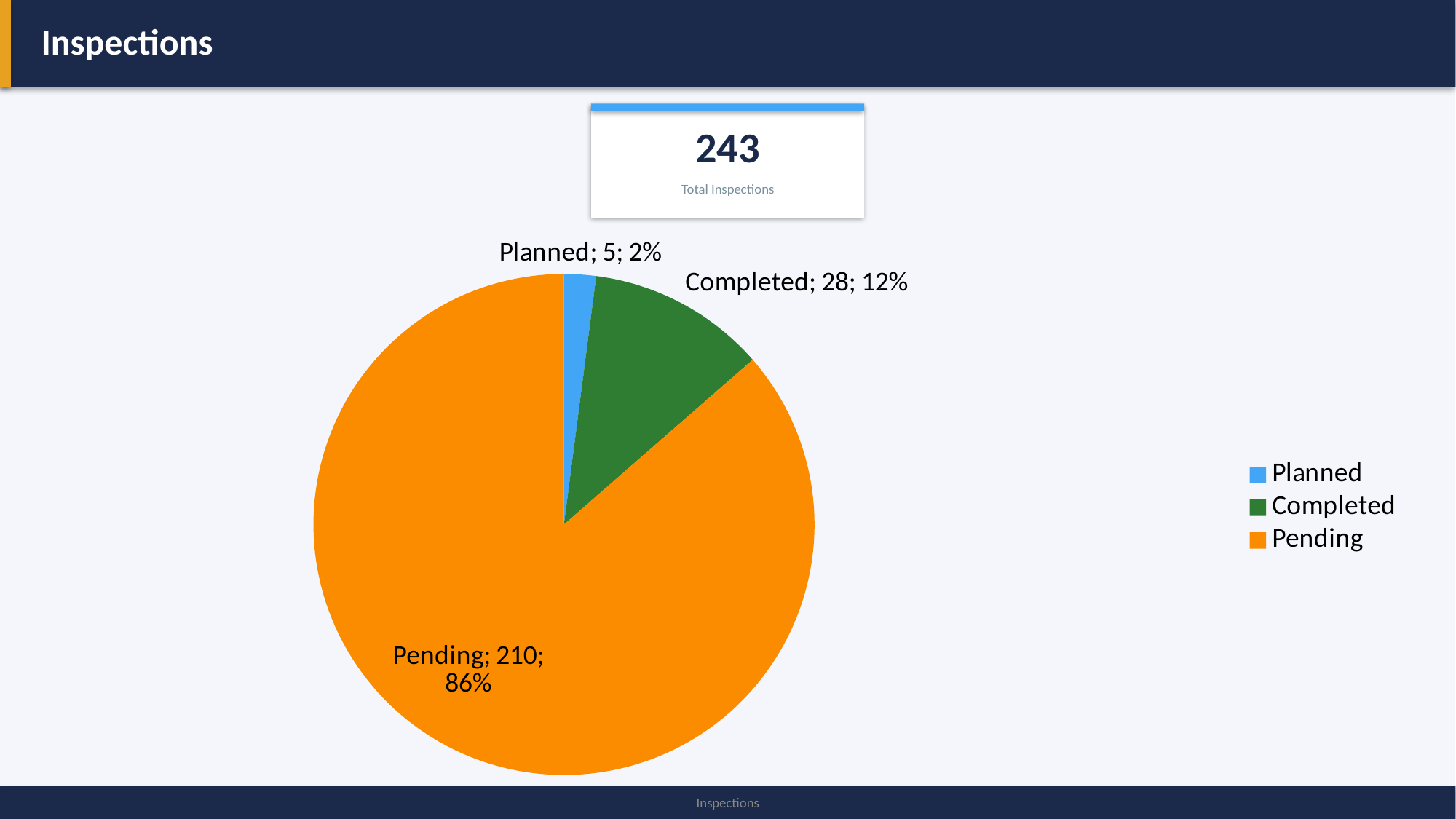
What is the value for Pending? 210 What share of the pie does Pending represent? 86% Which is larger, the value for Completed or the value for Planned? Completed Which category has the largest slice? Pending How many slices does the pie chart have? 3 What is the value for Planned? 5 What kind of chart is shown on the slide? pie chart What is the difference between the values for Completed and Planned? 23 How many entries does the legend list? 3 What share of the pie does Completed represent? 12% Which category has the smallest slice? Planned What is the value for Completed? 28